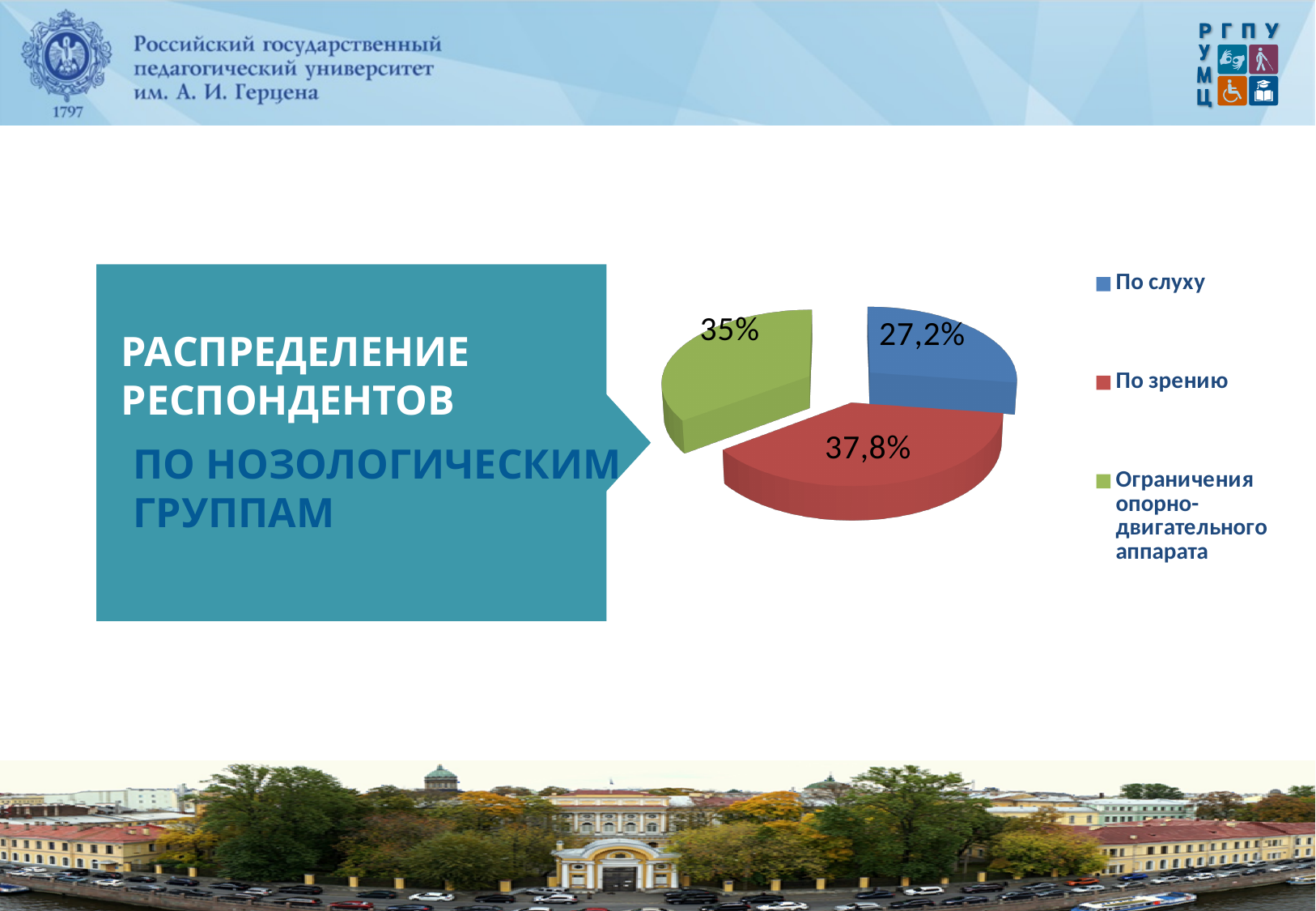
What share of respondents is in the "Ограничения опорно-двигательного аппарата" group? 35% What share of respondents is in the "По слуху" group? 27,2% What is the difference in percentage points between the "По зрению" and "Ограничения опорно-двигательного аппарата" shares? 2,8 What kind of chart is shown on the slide? Pie chart Which is larger: the share for "По слуху" or the share for "Ограничения опорно-двигательного аппарата"? Ограничения опорно-двигательного аппарата How many slices does the pie chart have? 3 Which colour represents the "По зрению" group in the pie chart? Red What is the difference in percentage points between the "По зрению" and "По слуху" shares? 10,6 Which nosological group has the largest share of respondents? По зрению What share of respondents is in the "По зрению" group? 37,8% Which nosological group has the smallest share of respondents? По слуху What is the title of the chart on the slide? Распределение респондентов по нозологическим группам